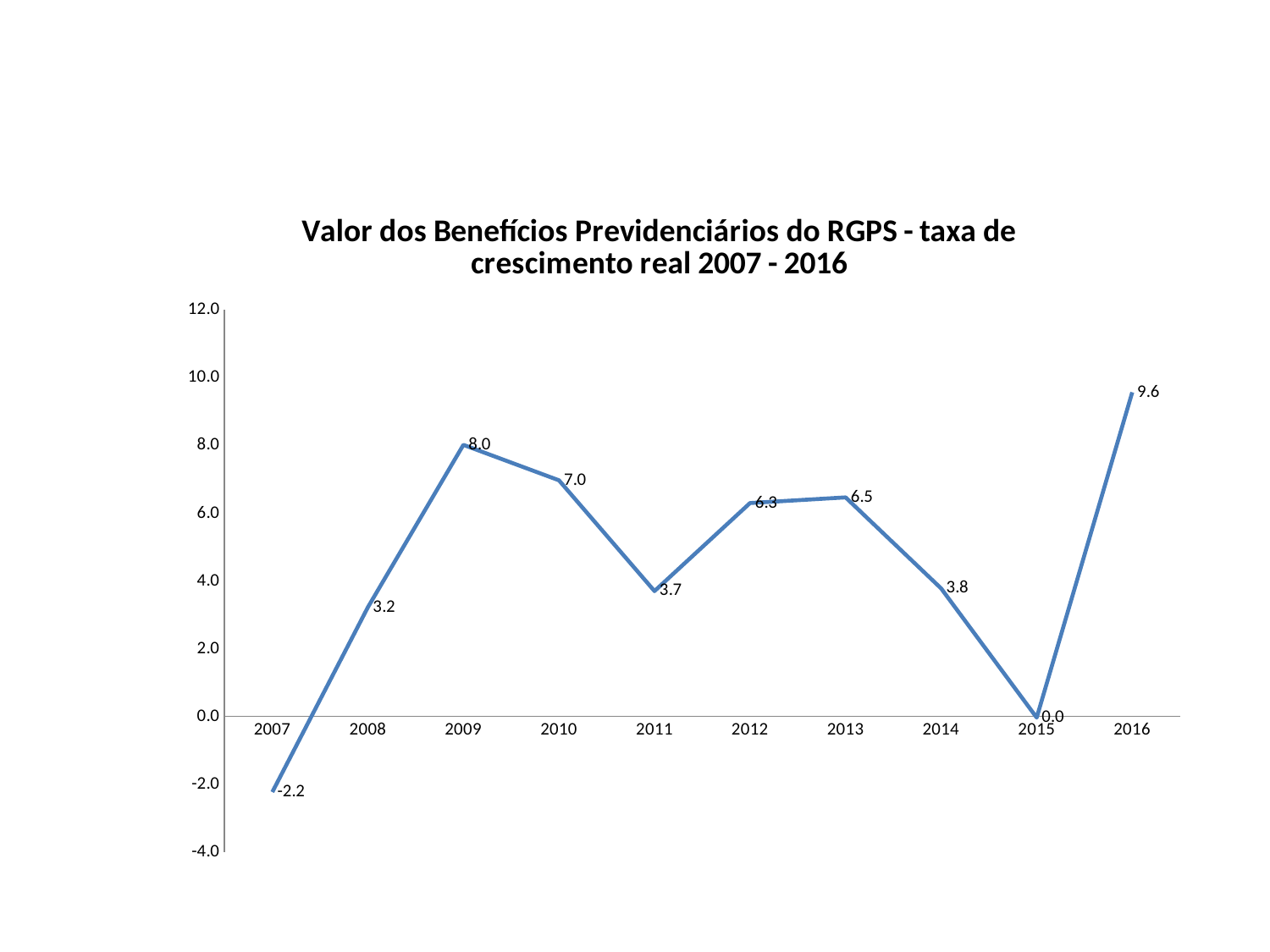
Which year has the lowest value? 2007 What is the value for 2009? 8.0 What kind of chart is shown? line chart Do the values rise or fall from 2013 to 2015? fall How many years are plotted on the chart? 10 What is the value for 2015? 0.0 What is the value for 2007? -2.2 Is the value for 2012 greater or less than 4.0? greater Which year has the highest value? 2016 Which is larger, the value for 2011 or the value for 2014? 2014 What is the difference between the values for 2009 and 2010? 1.0 What is the difference between the values for 2016 and 2015? 9.6